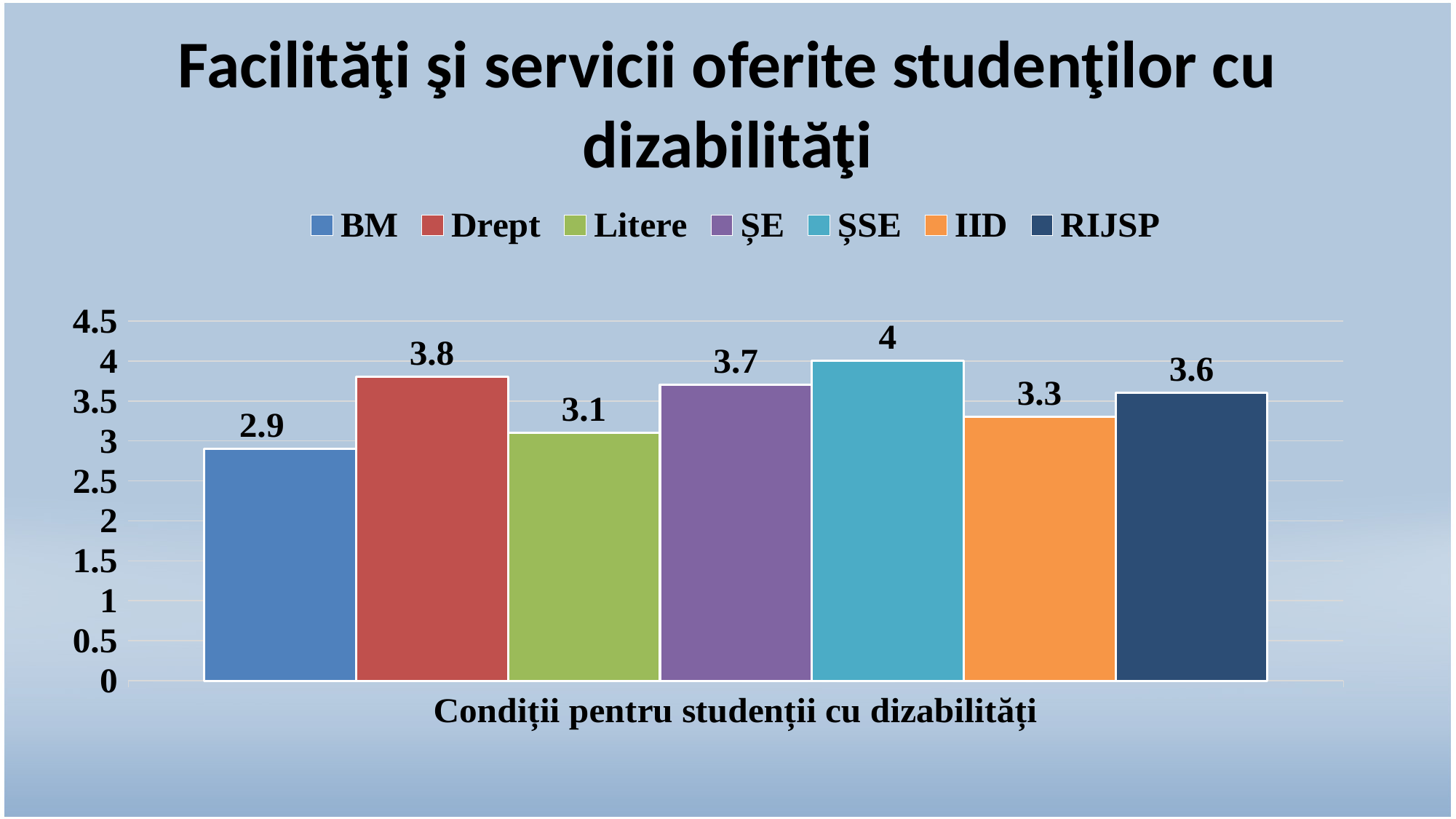
What is the value for IID? 3.3 Which series has the highest value? ŞSE What kind of chart is shown on the slide? bar chart What is the difference between the values for Drept and Litere? 0.7 What is the x-axis label of the chart? Condiţii pentru studenţii cu dizabilităţi Which series has the lowest value? BM What is the value for Drept? 3.8 Is the value for Litere greater or less than 3.5? less How many series does the legend list? 7 What is the difference between the values for ŞSE and BM? 1.1 What is the value for BM? 2.9 Which is larger, the value for ŞE or the value for RIJSP? ŞE